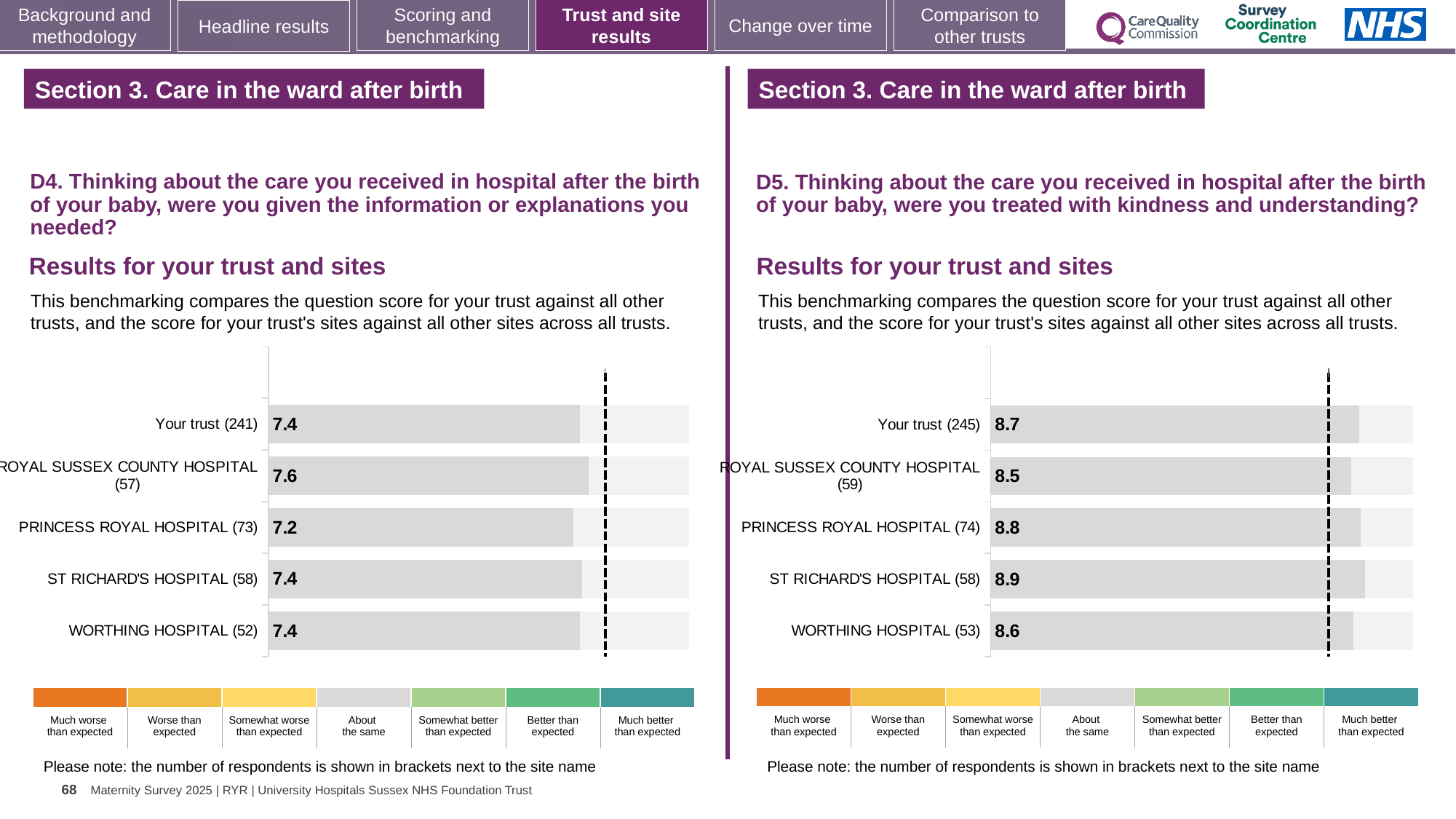
In the D5 chart on the right, which is higher: the score for Princess Royal Hospital or Worthing Hospital? Princess Royal Hospital In the D4 chart on the left, which site has the highest score? Royal Sussex County Hospital In the D5 chart on the right, what is the score for St Richard's Hospital? 8.9 In the D5 chart on the right, what is the difference between the scores for St Richard's Hospital and Your trust? 0.2 In the D5 chart on the right, which site has the lowest score? Royal Sussex County Hospital In the D5 chart on the right, what is the score for Worthing Hospital? 8.6 In the D4 chart on the left, what is the difference between the scores for Royal Sussex County Hospital and Princess Royal Hospital? 0.4 What type of chart is used in the D5 chart on the right? Bar chart In the D4 chart on the left, what is the score for Your trust? 7.4 In the D4 chart on the left, which site has the lowest score? Princess Royal Hospital In the D4 chart on the left, what is the score for Princess Royal Hospital? 7.2 How many bars are plotted in the D4 chart on the left? 5